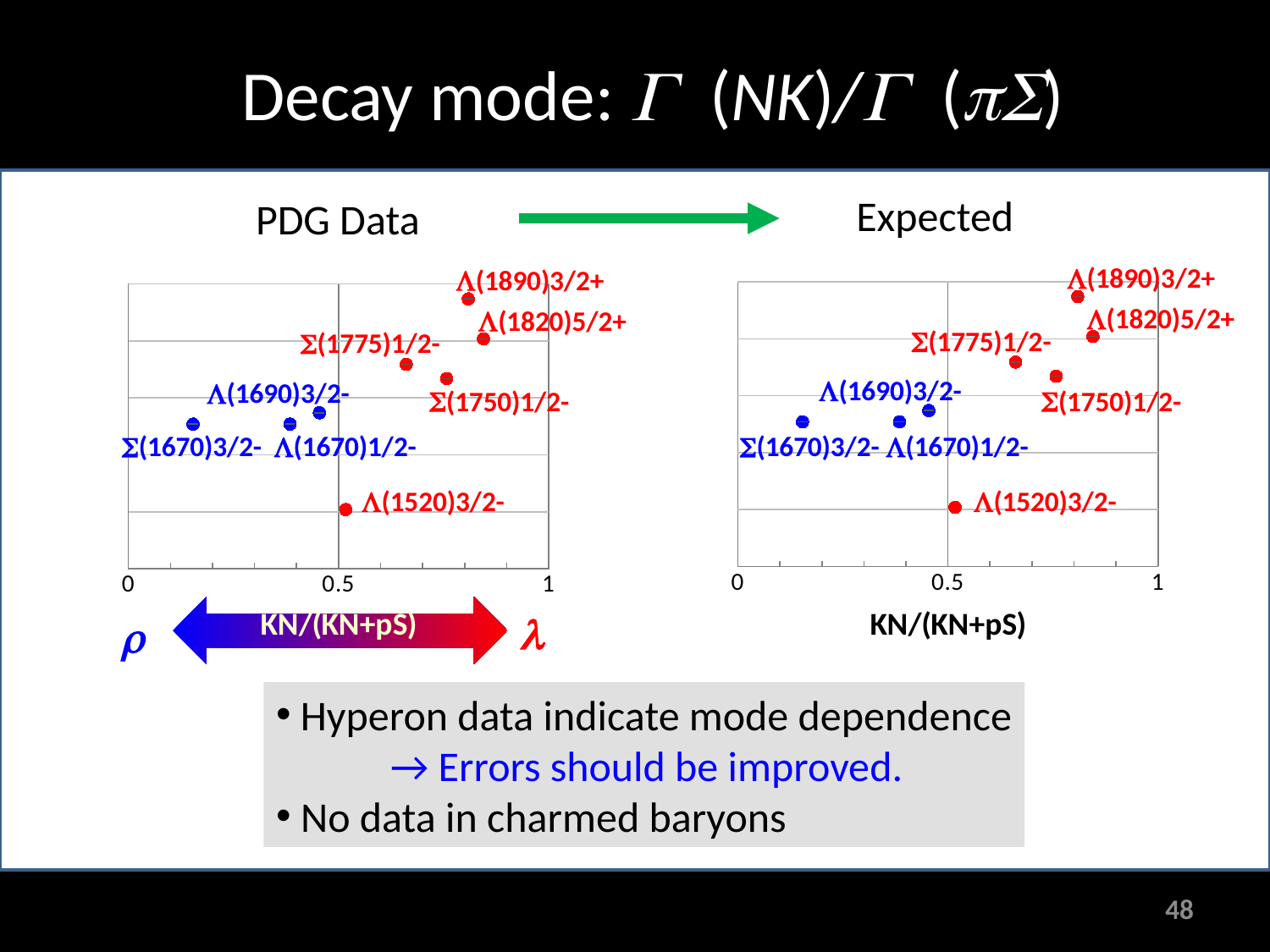
In the "Expected" chart, which point is plotted highest on the vertical axis? Λ(1890)3/2+ In the "Expected" chart, which has the larger KN/(KN+pS) value, Λ(1820)5/2+ or Σ(1775)1/2-? Λ(1820)5/2+ How many data points are plotted in the "Expected" chart? 8 What is the title of the chart on the left of the slide? PDG Data In the "PDG Data" chart, is the KN/(KN+pS) value for Σ(1670)3/2- greater or less than 0.5? less In the "PDG Data" chart, which point is plotted lowest on the vertical axis? Λ(1520)3/2- In the "Expected" chart, is the KN/(KN+pS) value for Λ(1890)3/2+ greater or less than 0.5? greater What is the x-axis label of the "Expected" chart? KN/(KN+pS) In the "PDG Data" chart, is the KN/(KN+pS) value for Σ(1775)1/2- greater or less than 0.5? greater In the "PDG Data" chart, which has the larger KN/(KN+pS) value, Σ(1670)3/2- or Λ(1670)1/2-? Λ(1670)1/2- What kind of chart is the "PDG Data" chart? scatter chart In the "PDG Data" chart, which point has the lowest KN/(KN+pS) value? Σ(1670)3/2-